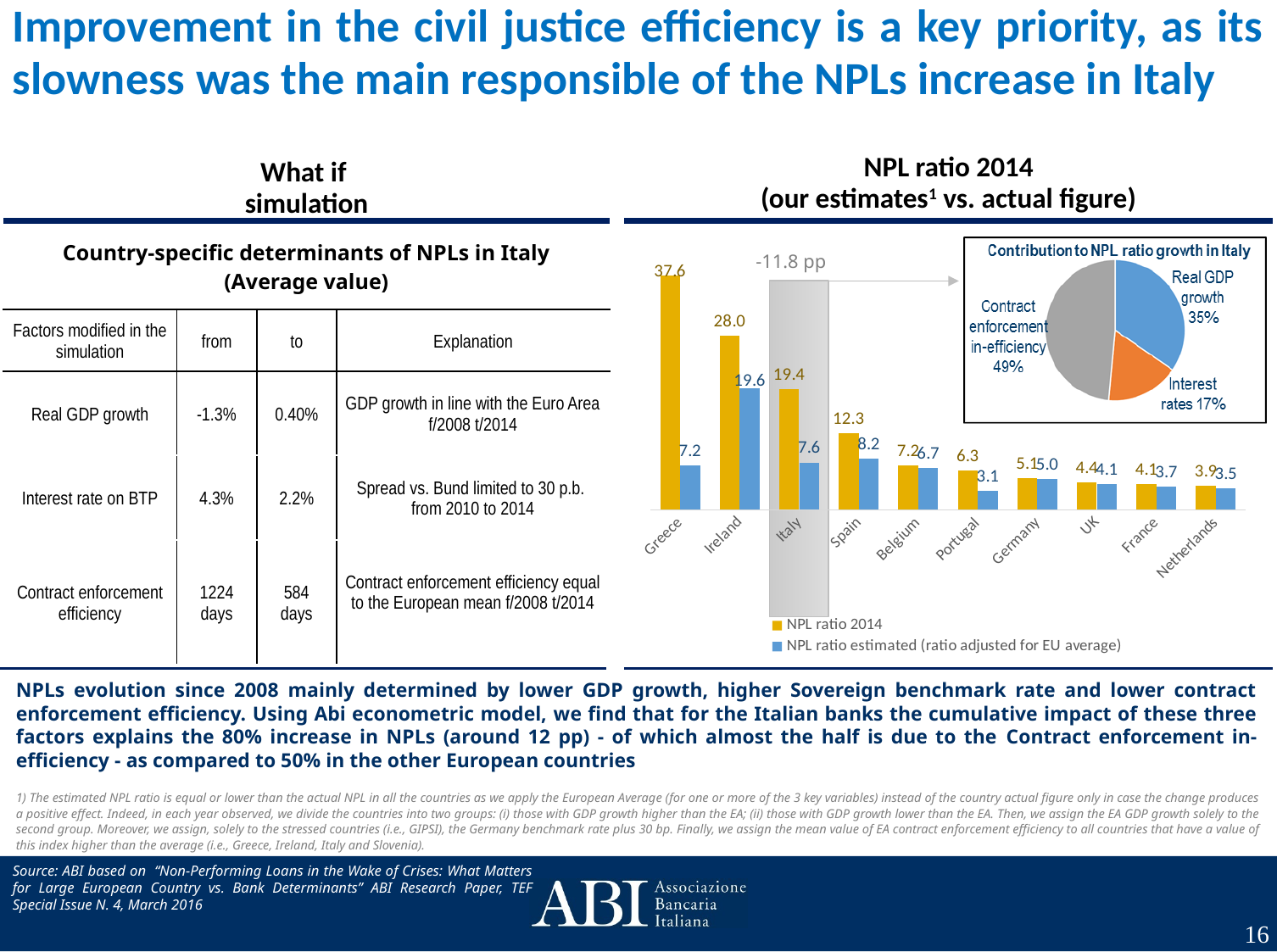
In the pie chart 'Contribution to NPL ratio growth in Italy', what share is attributed to Contract enforcement in-efficiency? 49% In the NPL ratio 2014 bar chart, what is the difference between the NPL ratio 2014 and the NPL ratio estimated for Italy? 11.8 In the NPL ratio 2014 bar chart, what is the NPL ratio estimated for Portugal? 3.1 How many countries are shown in the NPL ratio 2014 bar chart? 10 How many series does the legend of the NPL ratio 2014 bar chart list? 2 In the NPL ratio 2014 bar chart, which country has the lowest NPL ratio 2014? Netherlands In the NPL ratio 2014 bar chart, which country has the highest NPL ratio 2014? Greece In the NPL ratio 2014 bar chart, what is the NPL ratio estimated (ratio adjusted for EU average) for Italy? 7.6 In the NPL ratio 2014 bar chart, which is larger for Ireland: the NPL ratio 2014 or the NPL ratio estimated? NPL ratio 2014 In the NPL ratio 2014 bar chart, what is the NPL ratio 2014 for Greece? 37.6 What type of chart is the NPL ratio 2014 chart? Bar chart In the pie chart 'Contribution to NPL ratio growth in Italy', which factor has the smallest share? Interest rates